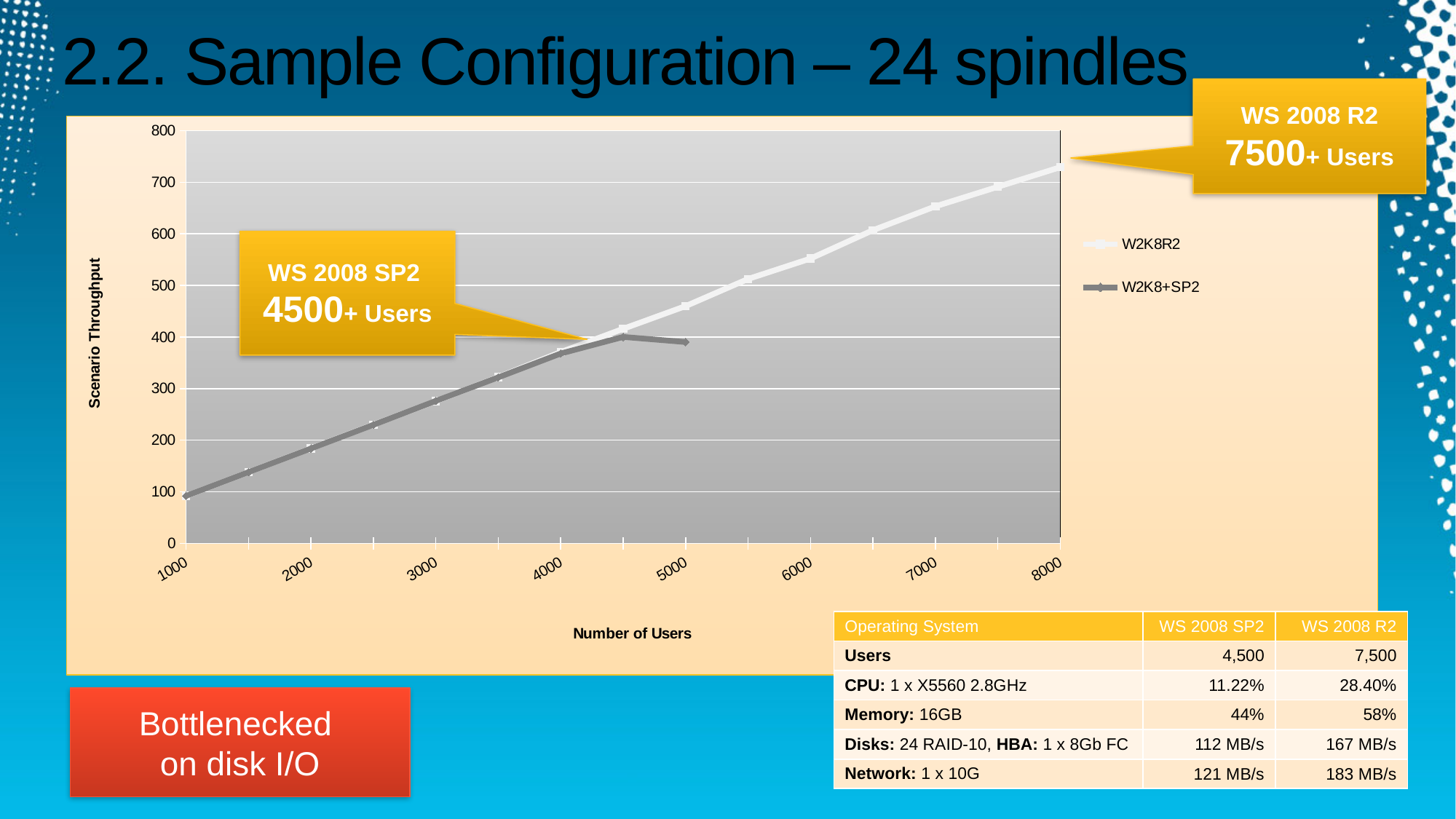
Does the W2K8R2 series rise or fall as the number of users increases? rises Is the W2K8+SP2 value at 2000 users greater or less than 200? less How many series does the chart legend list? 2 Is the W2K8R2 value at 7000 users greater or less than 600? greater What are the two series named in the chart legend? W2K8R2 and W2K8+SP2 Is the W2K8R2 value at 6000 users greater or less than 500? greater Which series reaches the highest scenario throughput on the chart? W2K8R2 What kind of chart is shown on the slide? line chart At 5000 users, which series has the higher scenario throughput, W2K8R2 or W2K8+SP2? W2K8R2 What is the title of the chart's y axis? Scenario Throughput